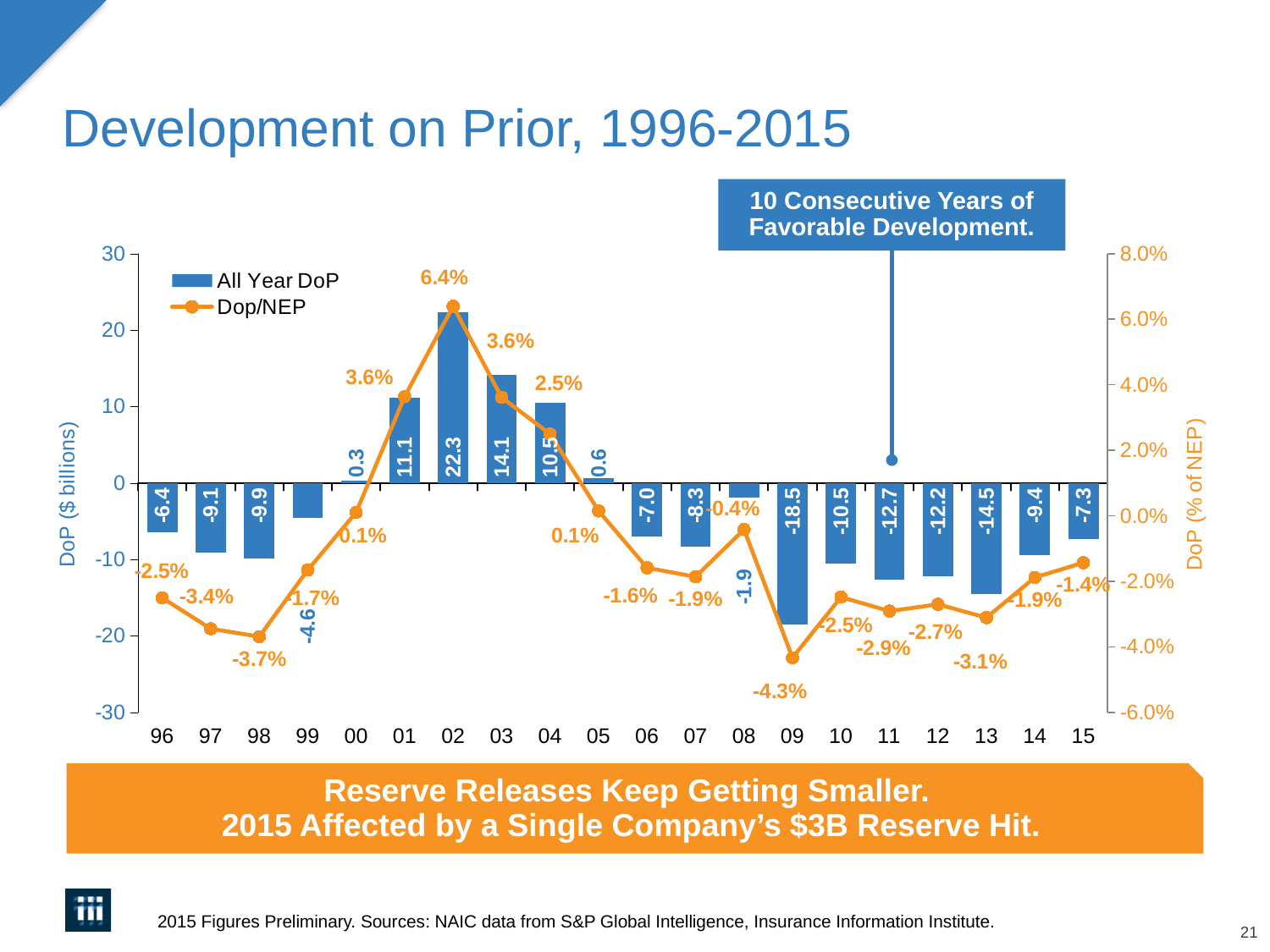
What is the Dop/NEP value for 2009? -4.3% What is the All Year DoP value (in $ billions) for 2002? 22.3 Which is larger, the All Year DoP value for 2011 or for 2012? 2012 Which year has the highest Dop/NEP value? 02 What is the title of the chart? Development on Prior, 1996-2015 How many years are shown on the x axis? 20 What kind of chart is this? Combined bar and line chart What is the difference between the All Year DoP values for 2002 and 2003? 8.2 Which year has the highest All Year DoP value? 02 What is the All Year DoP value for 2015? -7.3 How many series does the legend list? 2 Which year has the lowest All Year DoP value? 09